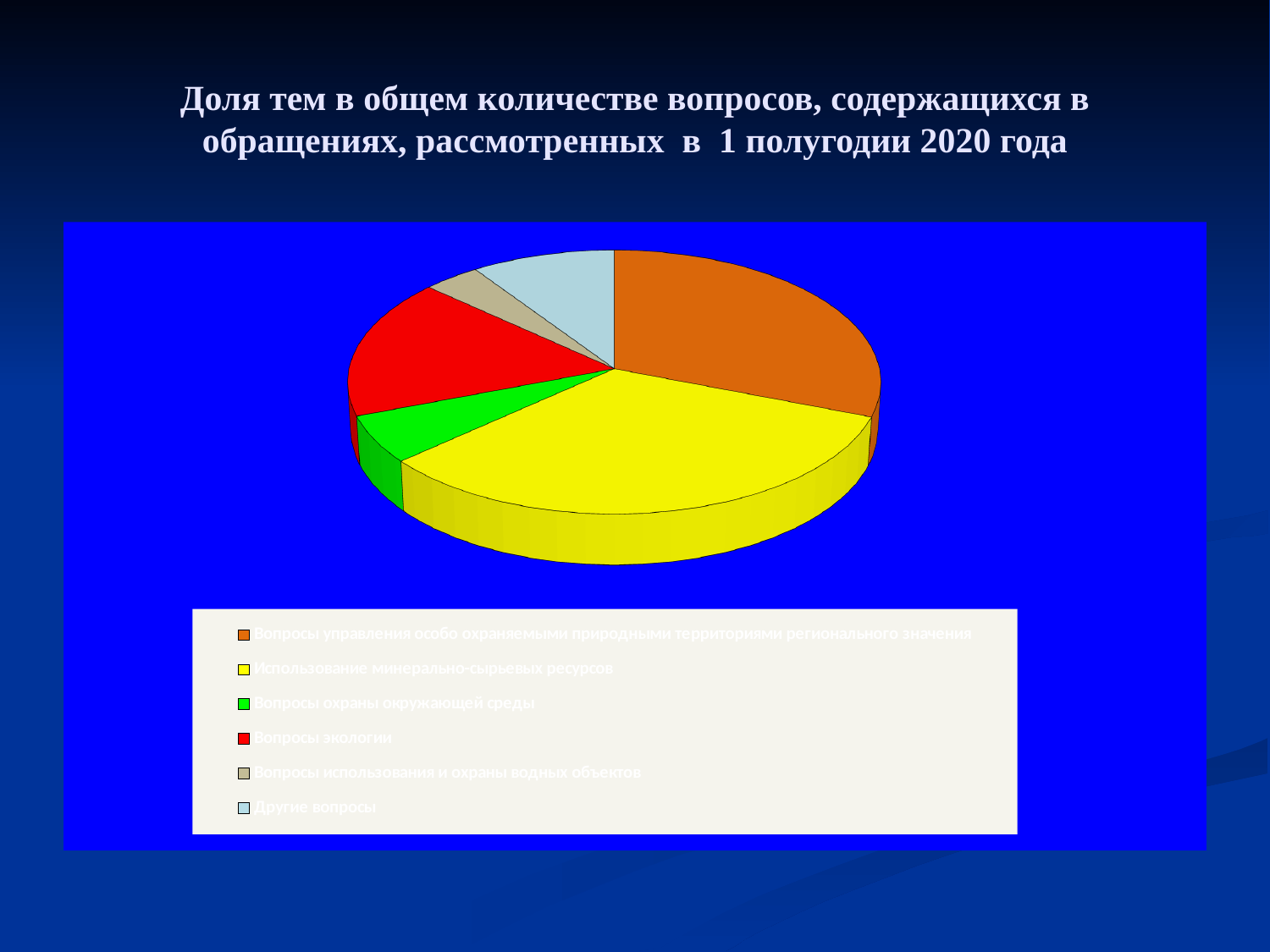
What is the title of the slide? Доля тем в общем количестве вопросов, содержащихся в обращениях, рассмотренных в 1 полугодии 2020 года Which category has the largest share of the pie? Использование минерально-сырьевых ресурсов Which slice is larger: "Вопросы экологии" or "Вопросы использования и охраны водных объектов"? Вопросы экологии Which slice is larger: "Использование минерально-сырьевых ресурсов" or "Вопросы управления особо охраняемыми природными территориями регионального значения"? Использование минерально-сырьевых ресурсов Which category has the smallest share of the pie? Вопросы использования и охраны водных объектов How many slices does the pie chart have? 6 What kind of chart is shown on the slide? Pie chart What colour is the slice for "Вопросы охраны окружающей среды"? Green Which slice is larger: "Вопросы экологии" or "Другие вопросы"? Вопросы экологии